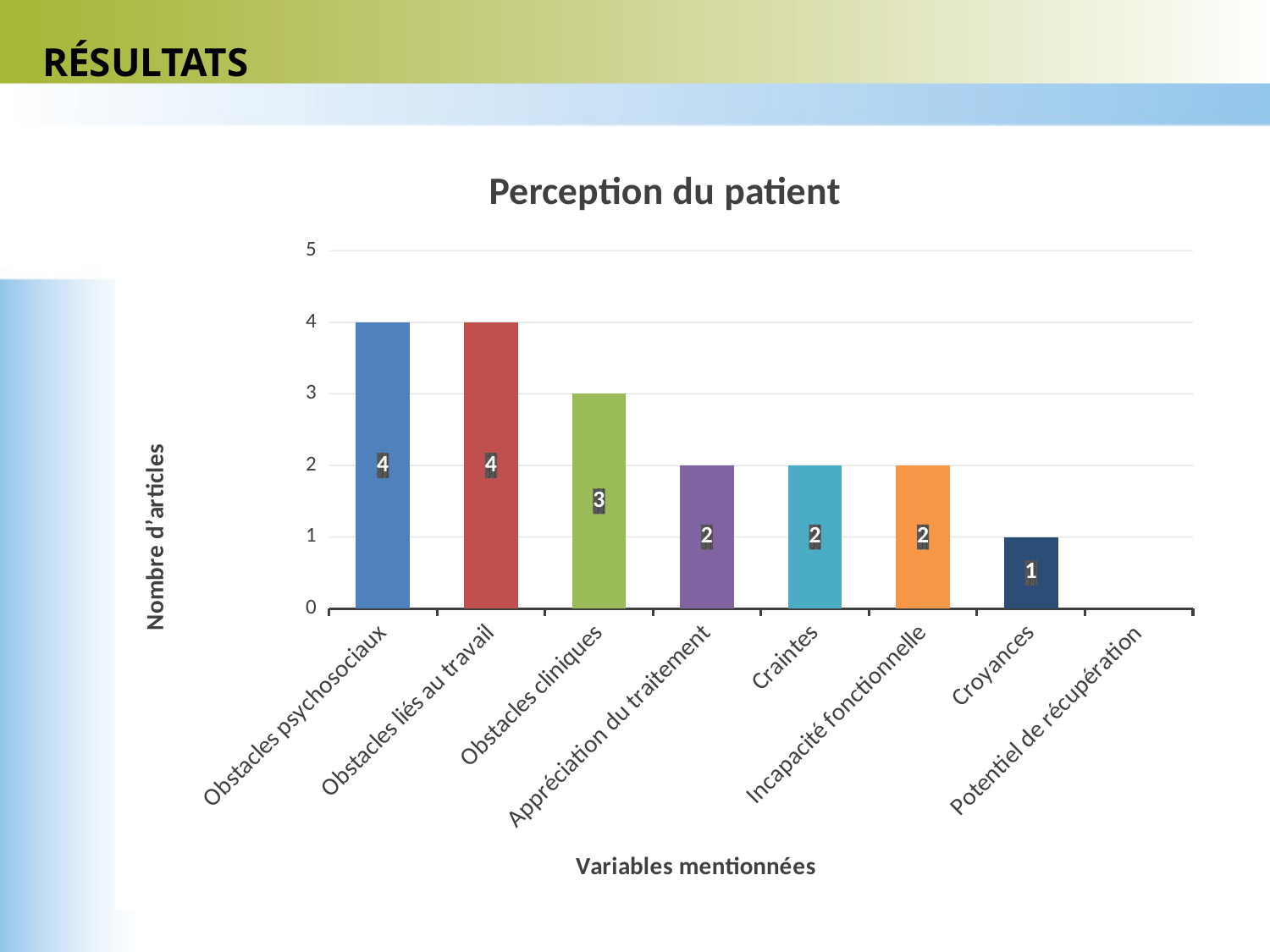
What is the difference between the values for Obstacles cliniques and Croyances? 2 What is the title of the y axis? Nombre d'articles Which is larger, the value for Obstacles cliniques or the value for Appréciation du traitement? Obstacles cliniques What is the value for Incapacité fonctionnelle? 2 Is the value for Obstacles psychosociaux greater or less than 3? greater What is the value for Obstacles cliniques? 3 What is the difference between the values for Obstacles liés au travail and Craintes? 2 What kind of chart is shown on the slide? bar chart What is the value for Obstacles psychosociaux in the Perception du patient chart? 4 How many categories are labeled on the x axis of the chart? 8 What is the value for Croyances? 1 Do the bar values rise or fall from left to right along the x axis? fall